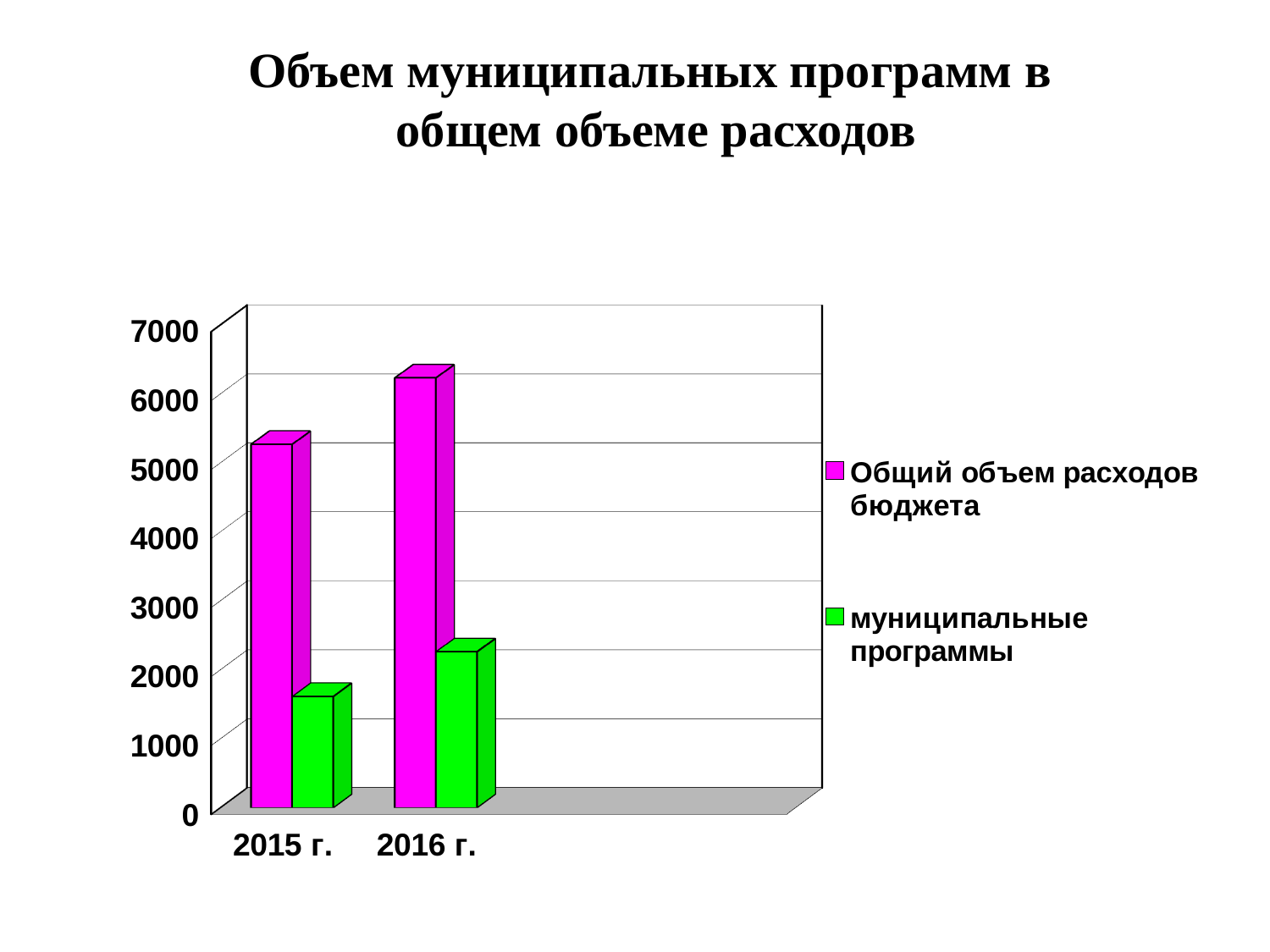
What is the title of the chart? Объем муниципальных программ в общем объеме расходов In which year is Общий объем расходов бюджета highest? 2016 г. Is the value for муниципальные программы in 2015 г. greater or less than 2000? less Is the value for Общий объем расходов бюджета in 2015 г. greater or less than 5000? greater What kind of chart is shown on the slide? bar chart Do the values for Общий объем расходов бюджета rise or fall from 2015 г. to 2016 г.? rise How many series does the legend list? 2 Which is larger: муниципальные программы in 2015 г. or in 2016 г.? 2016 г. Is the value for Общий объем расходов бюджета in 2016 г. greater or less than 6000? greater Which series is shown in green in the legend? муниципальные программы How many categories are shown on the x axis? 2